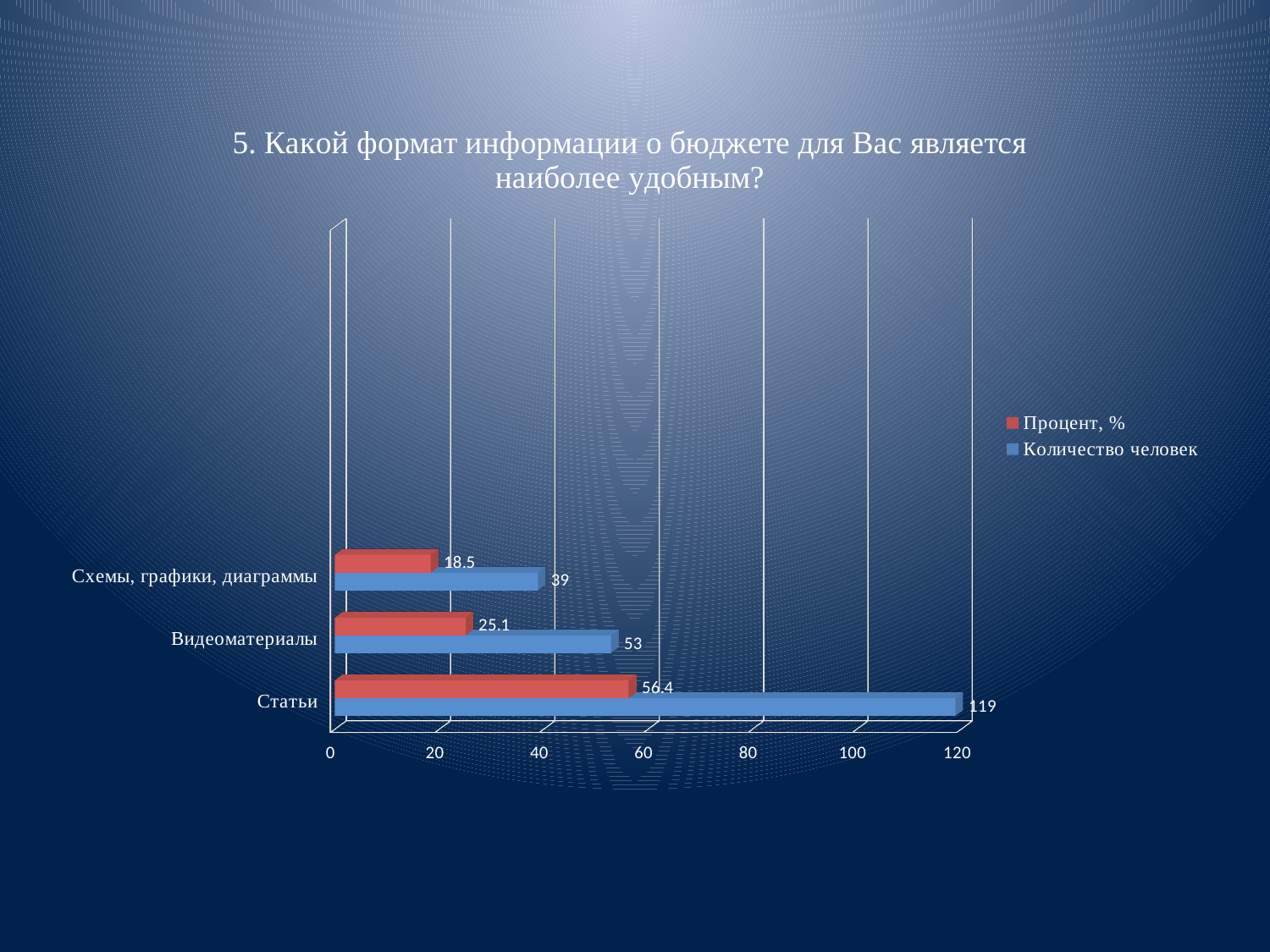
What kind of chart is shown on the slide? bar chart What is the difference between the "Количество человек" values for "Статьи" and "Видеоматериалы"? 66 How many categories are shown on the chart? 3 What is the value of "Процент, %" for "Видеоматериалы"? 25.1 What is the value of "Количество человек" for "Видеоматериалы"? 53 What is the value of "Процент, %" for "Схемы, графики, диаграммы"? 18.5 Is the "Количество человек" value for "Статьи" greater or less than 100? greater What is the value of "Количество человек" for "Статьи"? 119 Which category has the lowest value for "Процент, %"? Схемы, графики, диаграммы Which is larger: the "Количество человек" value for "Видеоматериалы" or for "Схемы, графики, диаграммы"? Видеоматериалы How many series does the legend list? 2 Which category has the highest value for "Количество человек"? Статьи